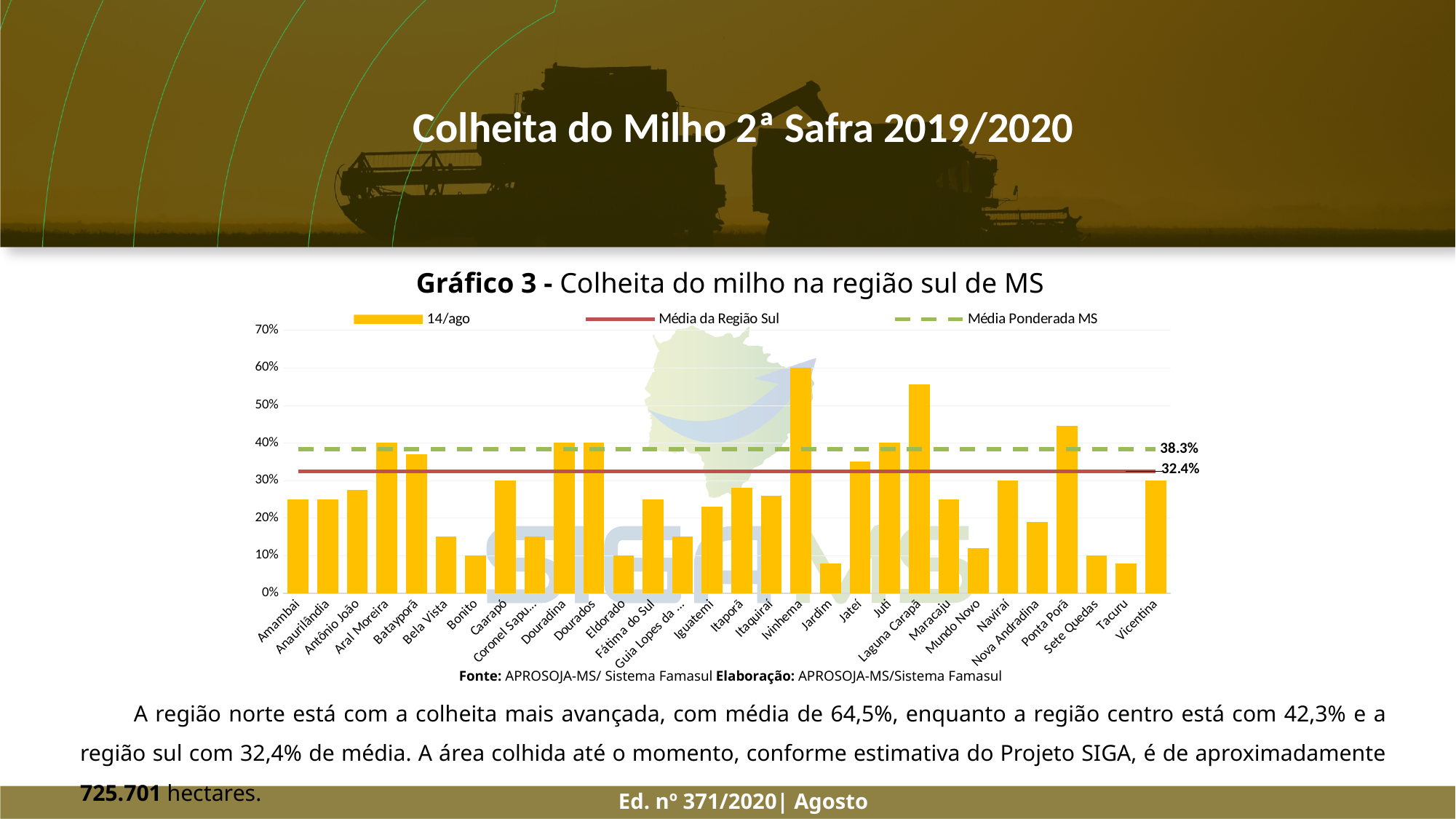
Is the value for Ponta Porã greater or less than 40%? greater What value is printed for the Média Ponderada MS line in Gráfico 3? 38.3% What is the difference between the Média Ponderada MS and the Média da Região Sul values printed in Gráfico 3? 5.9% How many series does the legend of Gráfico 3 list? 3 What type of chart is Gráfico 3? bar chart Is the value for Bela Vista greater or less than 20%? less Is the value for Ivinhema greater or less than 50%? greater What value is printed for the Média da Região Sul line in Gráfico 3? 32.4% Which is larger in Gráfico 3, the bar for Ivinhema or the bar for Laguna Carapã? Ivinhema Which is larger in Gráfico 3, the bar for Ponta Porã or the bar for Jateí? Ponta Porã Which municipality has the highest bar in Gráfico 3? Ivinhema How many municipalities are shown on the x axis of Gráfico 3? 30